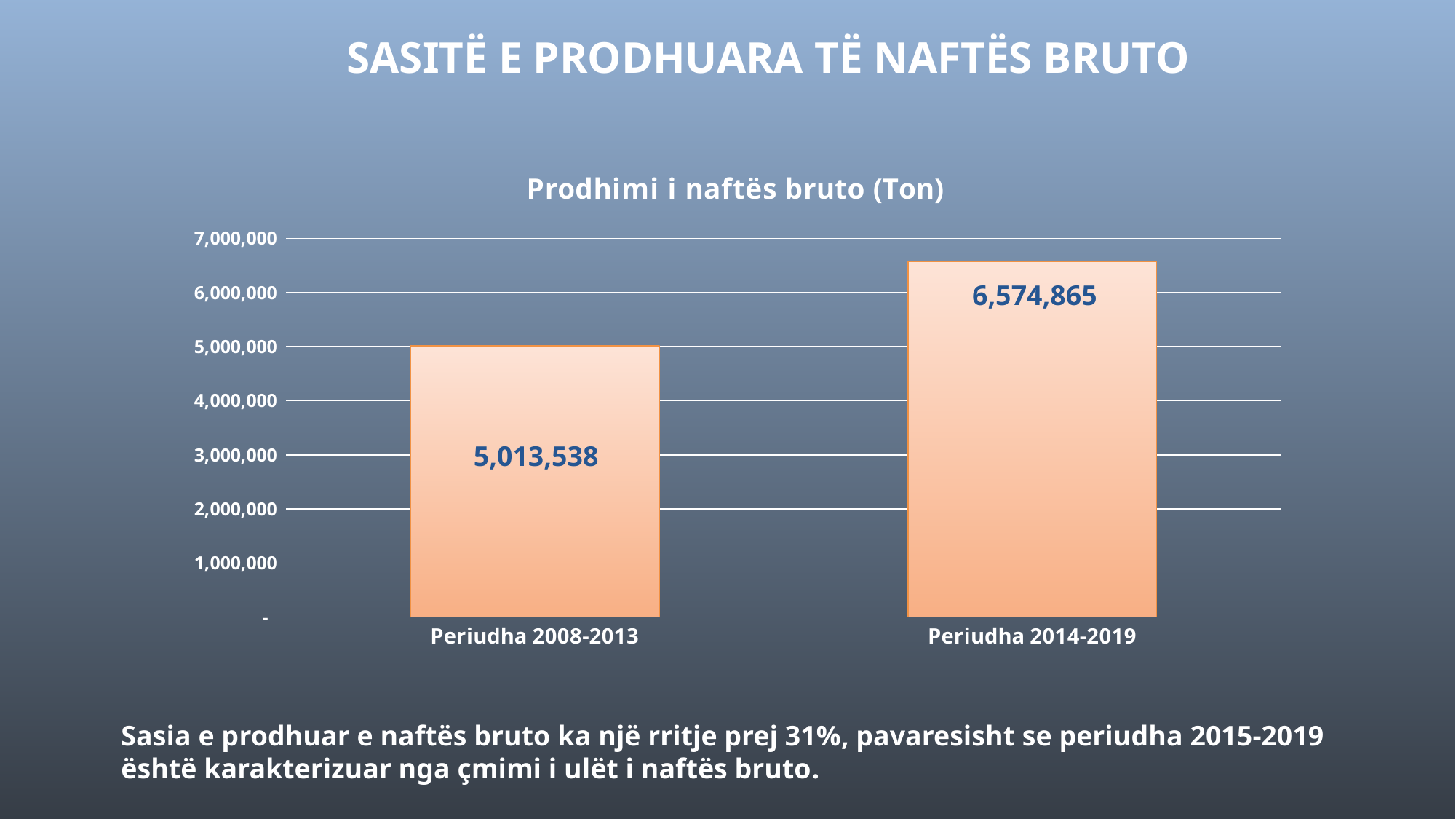
Which period has the lowest crude oil production? Periudha 2008-2013 Which is larger, the value for Periudha 2008-2013 or Periudha 2014-2019? Periudha 2014-2019 What kind of chart is shown on the slide? bar chart How many categories are shown in the chart? 2 Is the value for Periudha 2014-2019 greater or less than 6,000,000? greater Is the value for Periudha 2008-2013 greater or less than 6,000,000? less What is the title of the chart? Prodhimi i naftës bruto (Ton) What is the difference between the values for Periudha 2014-2019 and Periudha 2008-2013? 1,561,327 What is the value for Periudha 2014-2019? 6,574,865 Which period has the highest crude oil production? Periudha 2014-2019 Do the values rise or fall from Periudha 2008-2013 to Periudha 2014-2019? rise What is the value for Periudha 2008-2013? 5,013,538